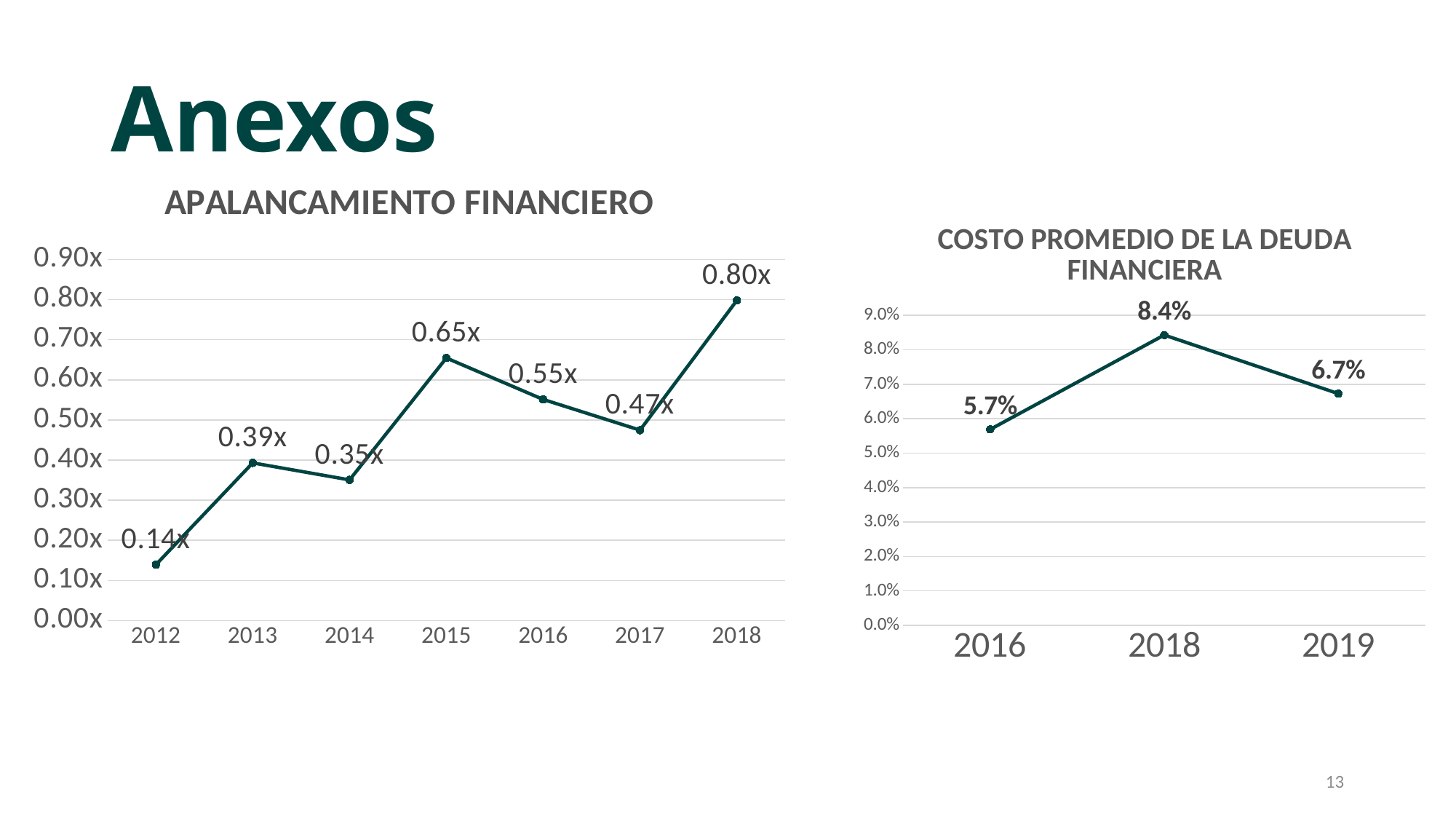
How many data points are plotted in the COSTO PROMEDIO DE LA DEUDA FINANCIERA chart? 3 In the APALANCAMIENTO FINANCIERO chart, what is the difference between the values for 2018 and 2017? 0.33x In the COSTO PROMEDIO DE LA DEUDA FINANCIERA chart, what is the value for 2018? 8.4% What kind of chart is the APALANCAMIENTO FINANCIERO chart? Line chart How many years are plotted in the APALANCAMIENTO FINANCIERO chart? 7 In the COSTO PROMEDIO DE LA DEUDA FINANCIERA chart, what is the difference between the values for 2018 and 2016? 2.7% In the APALANCAMIENTO FINANCIERO chart, which year has the lowest value? 2012 In the APALANCAMIENTO FINANCIERO chart, what is the value for 2015? 0.65x In the APALANCAMIENTO FINANCIERO chart, what is the value for 2012? 0.14x In the APALANCAMIENTO FINANCIERO chart, which year has the highest value? 2018 In the APALANCAMIENTO FINANCIERO chart, which is larger, the value for 2013 or the value for 2014? 2013 In the COSTO PROMEDIO DE LA DEUDA FINANCIERA chart, which year has the lowest value? 2016